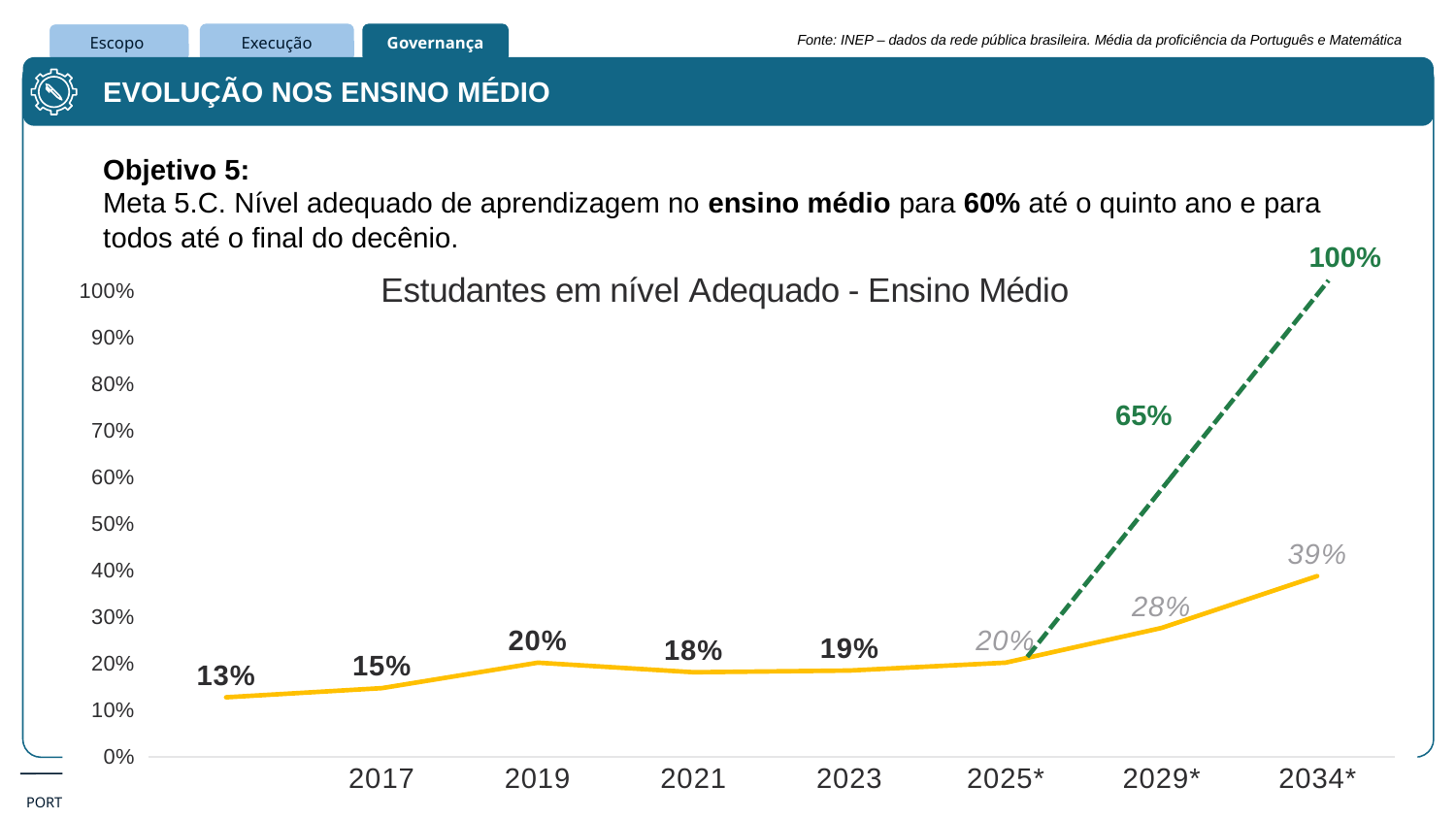
What is the value of the yellow line for 2017? 15% What is the value of the green dashed line for 2029*? 65% Does the yellow line rise or fall between 2025* and 2034*? rise What is the value of the yellow line for 2021? 18% What is the value of the yellow line for 2023? 19% What is the difference between the green dashed line and the yellow line at 2034*? 61% What is the value of the yellow line for 2019? 20% What is the value of the yellow line for 2034*? 39% What is the value of the green dashed line for 2034*? 100% What type of chart is shown on the slide? line chart Which is larger at 2029*: the green dashed line value or the yellow line value? green dashed line (65%) What is the title of the chart? Estudantes em nível Adequado - Ensino Médio